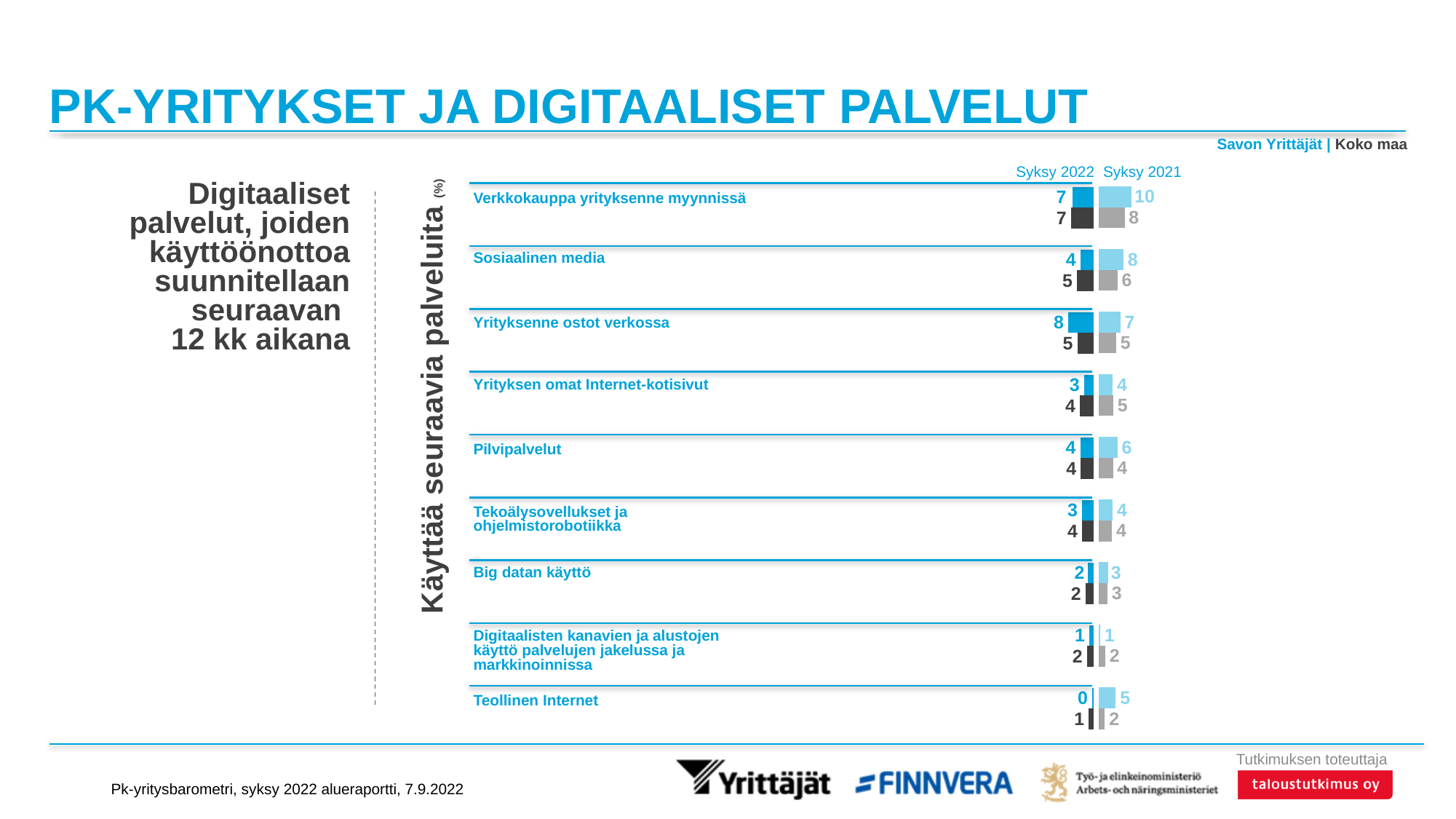
What is the Savon Yrittäjät value for Teollinen Internet in Syksy 2022? 0 How many categories (digital services) are listed in the chart? 9 What is the Koko maa value for Sosiaalinen media in Syksy 2022? 5 Which category has the lowest Savon Yrittäjät value in Syksy 2022? Teollinen Internet What is the difference between the Savon Yrittäjät Syksy 2021 and Syksy 2022 values for Sosiaalinen media? 4 Which two time periods are compared in the chart? Syksy 2022 and Syksy 2021 What kind of chart is shown on the slide? Bar chart Which category has the highest Savon Yrittäjät value in Syksy 2021? Verkkokauppa yrityksenne myynnissä What is the Savon Yrittäjät value for Verkkokauppa yrityksenne myynnissä in Syksy 2022? 7 What is the Savon Yrittäjät value for Verkkokauppa yrityksenne myynnissä in Syksy 2021? 10 Which category has the highest Savon Yrittäjät value in Syksy 2022? Yrityksenne ostot verkossa For Pilvipalvelut in Syksy 2021, which is larger: the Savon Yrittäjät value or the Koko maa value? Savon Yrittäjät